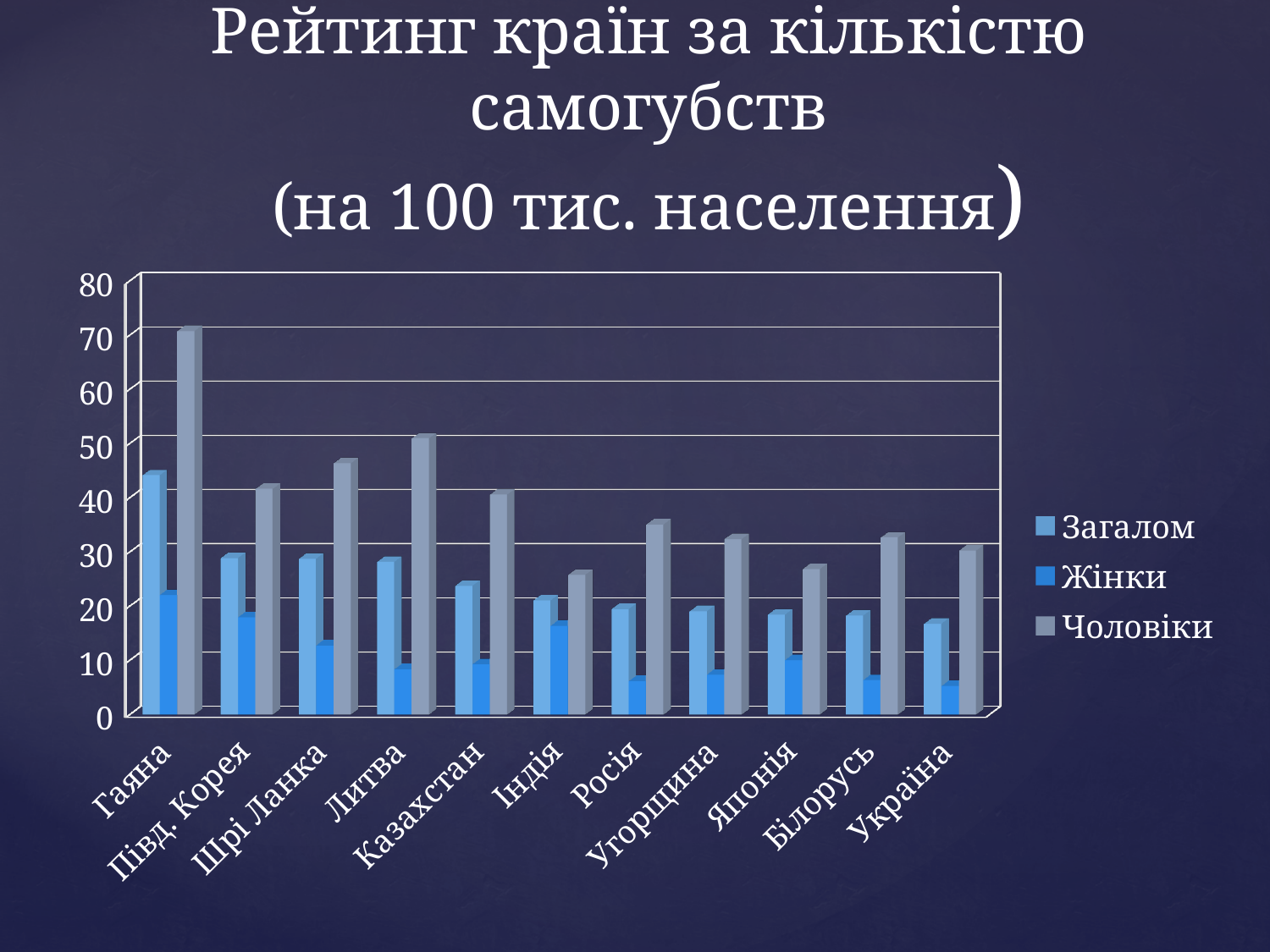
Do the Загалом values generally rise or fall from left to right along the x axis? fall What are the three series listed in the chart legend? Загалом, Жінки, Чоловіки How many countries are shown on the x axis of the chart? 11 Which is larger, the Чоловіки value for Литва or for Півд. Корея? Литва Is the Чоловіки value for Індія greater or less than 30? less Is the Чоловіки value for Гаяна greater or less than 60? greater Is the Загалом value for Гаяна greater or less than 40? greater What kind of chart is shown on the slide? bar chart Which country has the highest value for the Загалом series? Гаяна How many series does the chart legend list? 3 Which country has the highest value for the Чоловіки series? Гаяна